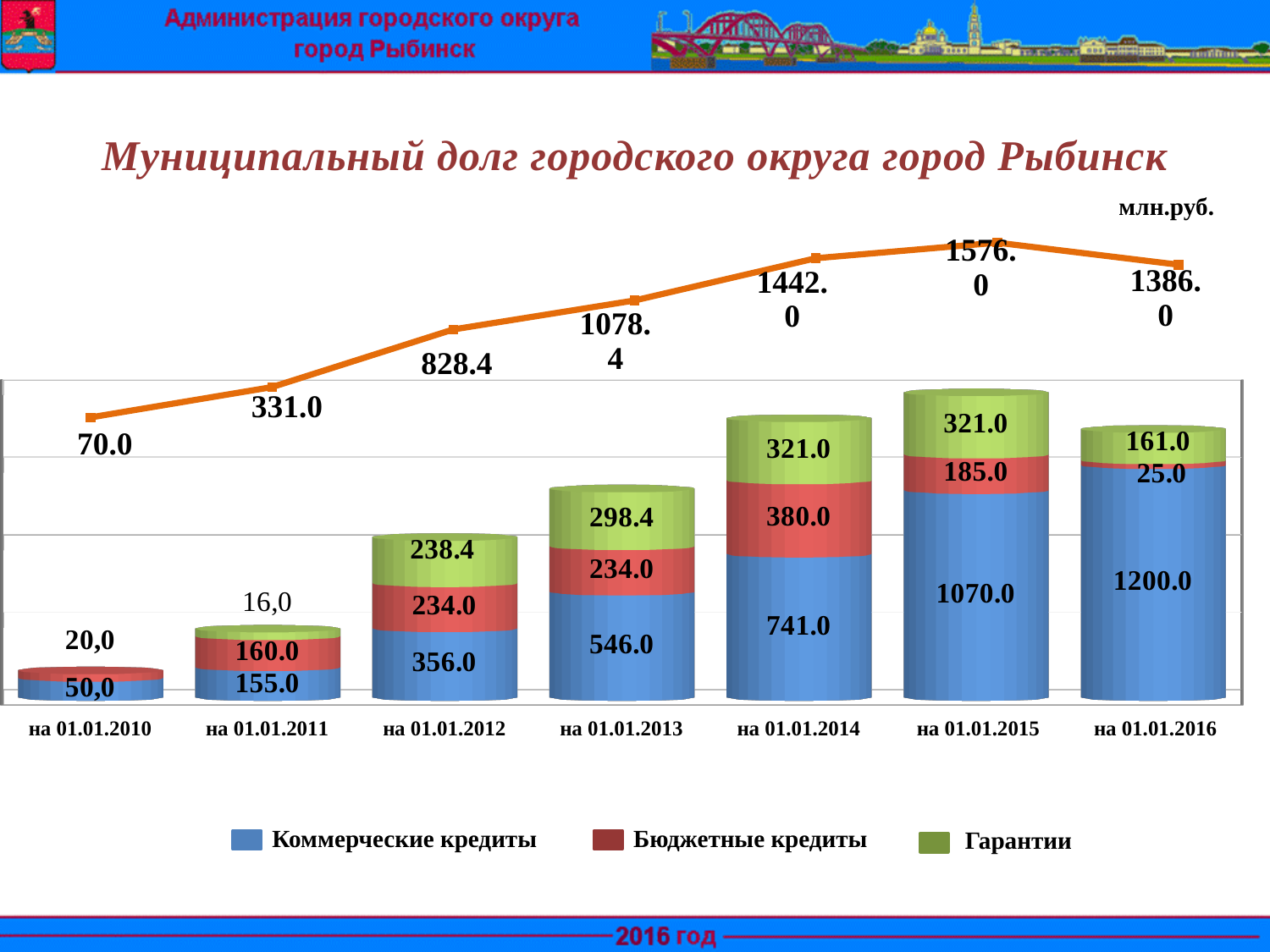
What is the title of the chart? Муниципальный долг городского округа город Рыбинск What kind of chart is this? Stacked bar chart with a line What is the value of Коммерческие кредиты for на 01.01.2016? 1200.0 What is the difference between the Коммерческие кредиты values for на 01.01.2015 and на 01.01.2014? 329.0 What is the value of Гарантии for на 01.01.2012? 238.4 How many categories are shown on the x axis? 7 How many series does the legend list? 3 Which category has the highest value for Коммерческие кредиты? на 01.01.2016 Which is larger: Бюджетные кредиты for на 01.01.2014 or for на 01.01.2015? на 01.01.2014 What total value does the line show for на 01.01.2015? 1576.0 Which category has the lowest total shown on the line? на 01.01.2010 What is the value of Бюджетные кредиты for на 01.01.2014? 380.0